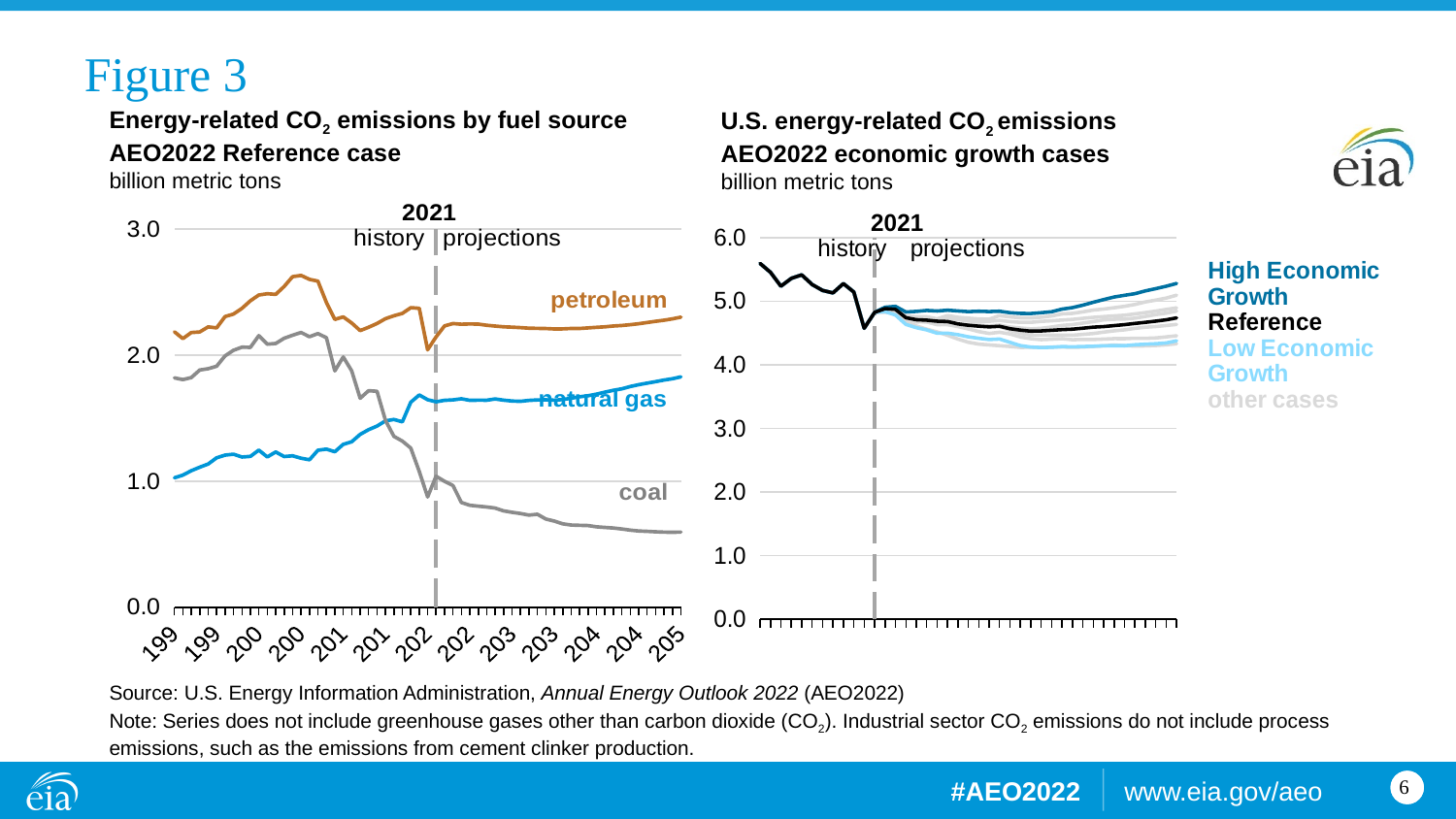
In the left chart, 'Energy-related CO2 emissions by fuel source', is the value for petroleum at the end of the projection period greater or less than 2.0? greater In the left chart, 'Energy-related CO2 emissions by fuel source', which fuel source has the lowest emissions at the end of the projection period? coal In the right chart, 'U.S. energy-related CO2 emissions', which case has the highest emissions at the end of the projection period? High Economic Growth What year does the dashed vertical line separating history from projections mark on both charts? 2021 In the right chart, 'U.S. energy-related CO2 emissions', which is larger at the end of the projection period, the Reference case or the Low Economic Growth case? Reference In the left chart, 'Energy-related CO2 emissions by fuel source', which fuel source has the highest emissions at the end of the projection period? petroleum In the left chart, 'Energy-related CO2 emissions by fuel source', is the value for coal at the end of the projection period greater or less than 1.0? less In the left chart, 'Energy-related CO2 emissions by fuel source', which is larger at the end of the projection period, natural gas or coal? natural gas In the left chart, 'Energy-related CO2 emissions by fuel source', how many fuel source series are plotted? 3 In the right chart, 'U.S. energy-related CO2 emissions', is the value for the Reference case at the end of the projection period greater or less than 5.0? less In the left chart, 'Energy-related CO2 emissions by fuel source', do coal emissions rise or fall over the projection period? fall What kind of chart is the left chart, 'Energy-related CO2 emissions by fuel source'? line chart